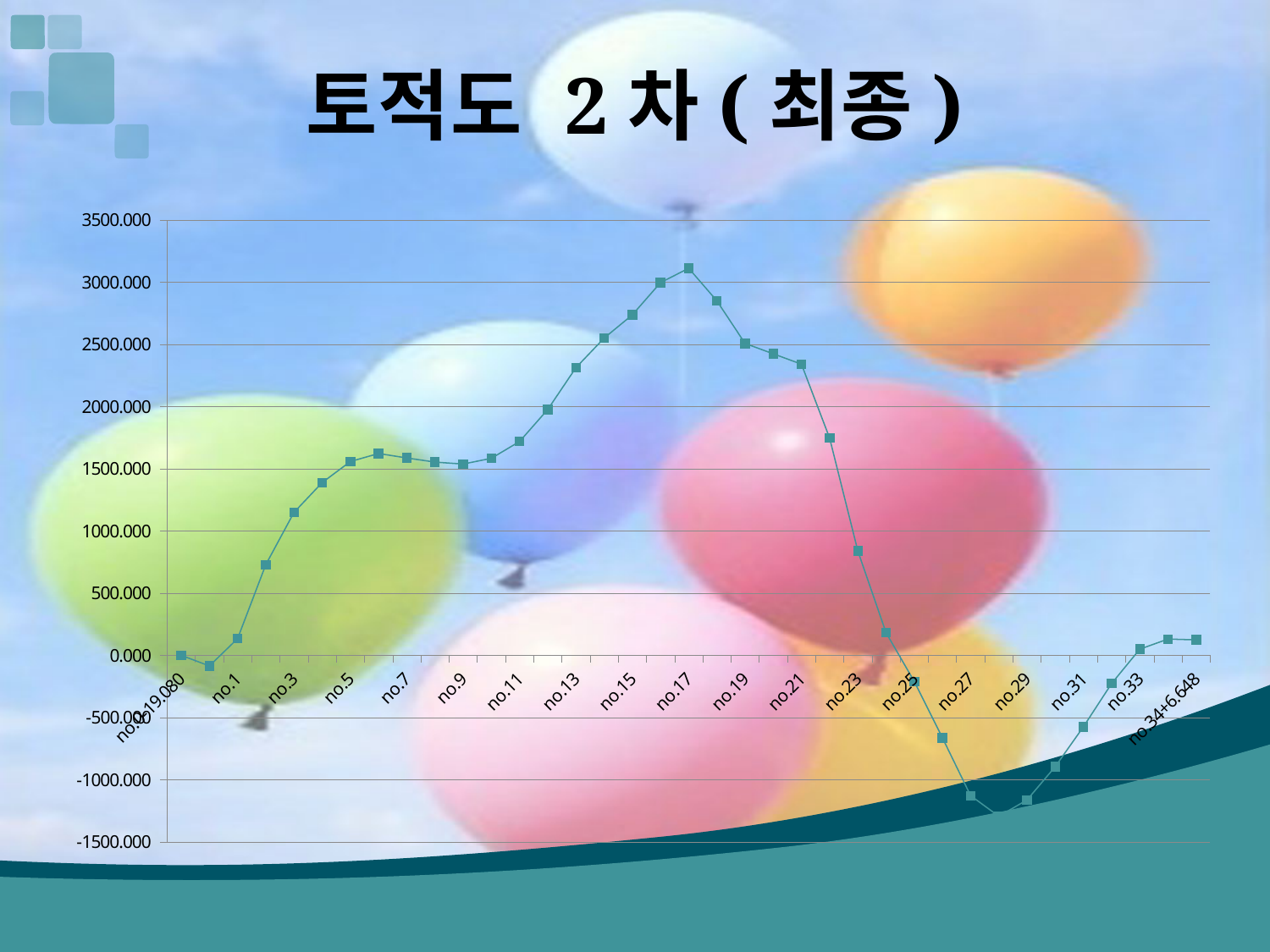
Which is larger, the value at no.17 or the value at no.9? no.17 What kind of chart is shown on the slide? line chart Is the value at no.27 greater or less than -500? less Is the value at no.23 greater or less than 1000? less Does the line rise or fall between no.17 and no.27? fall Is the value at no.13 greater or less than 2000? greater What is the title of the chart? 토적도 2차 (최종) What is the highest value shown on the vertical axis? 3500.000 At which labeled station does the line reach its highest value? no.17